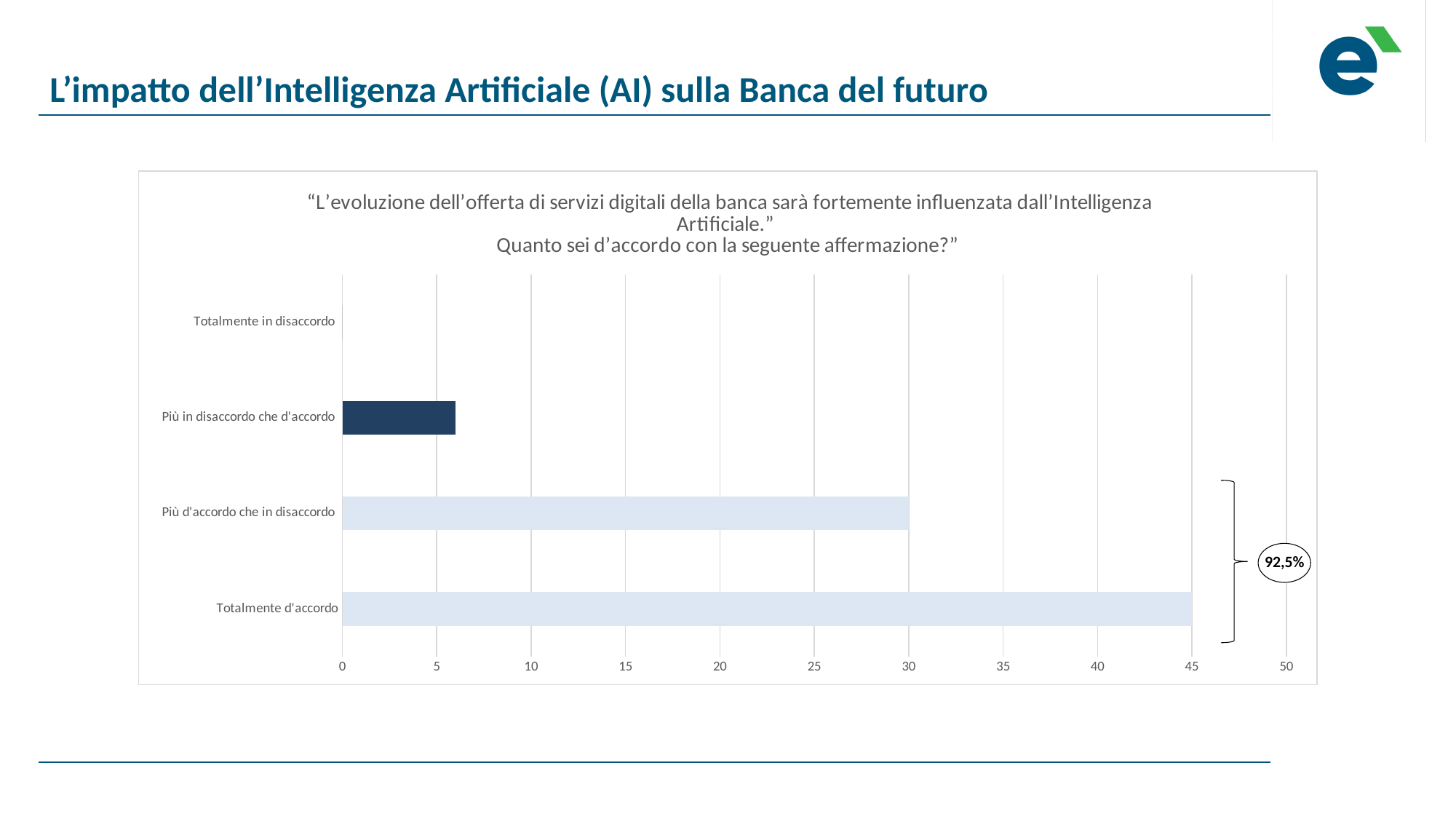
What kind of chart is shown on the slide? bar chart What is the value for Più d'accordo che in disaccordo? 30 Is the value for Più in disaccordo che d'accordo greater or less than 10? less What is the difference between the values for Totalmente d'accordo and Più d'accordo che in disaccordo? 15 Which category has the highest value? Totalmente d'accordo Which is larger: the value for Più in disaccordo che d'accordo or the value for Più d'accordo che in disaccordo? Più d'accordo che in disaccordo What is the highest tick value shown on the x axis of the chart? 50 What is the value for Totalmente d'accordo? 45 How many categories are shown on the chart? 4 Which category has the lowest value? Totalmente in disaccordo What percentage is shown in the circled annotation next to the bracket on the chart? 92,5% Is the value for Totalmente d'accordo greater or less than 40? greater